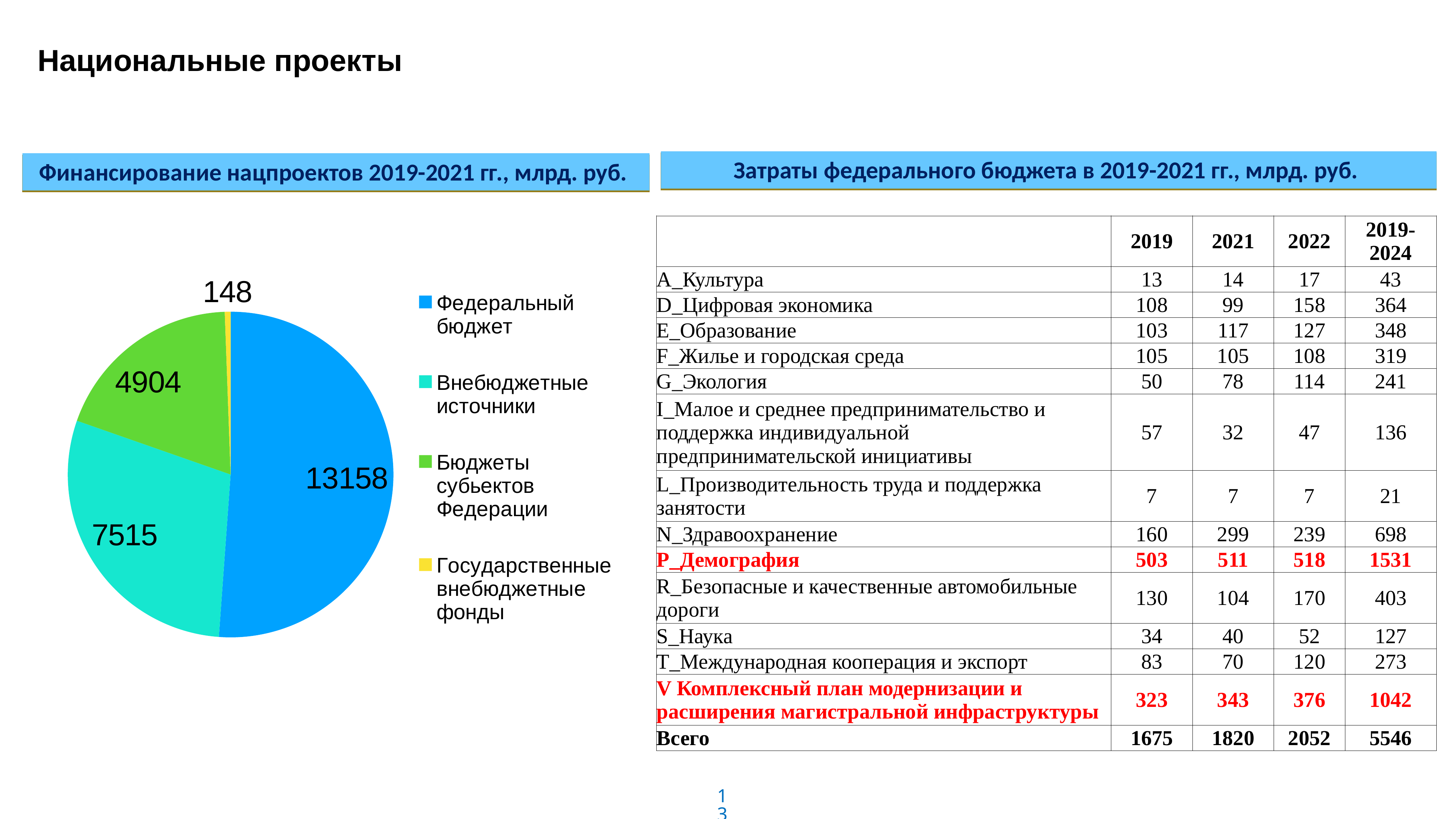
Which category has the largest slice in the pie chart? Федеральный бюджет In the pie chart, what is the value for Внебюджетные источники? 7515 How many slices does the pie chart have? 4 In the pie chart, what is the value for Федеральный бюджет? 13158 Which category has the smallest slice in the pie chart? Государственные внебюджетные фонды In the pie chart, which is larger: Внебюджетные источники or Бюджеты субъектов Федерации? Внебюджетные источники In the pie chart, what is the difference between Федеральный бюджет and Внебюджетные источники? 5643 What colour is the slice for Бюджеты субъектов Федерации in the pie chart? Green In the pie chart, what is the value for Государственные внебюджетные фонды? 148 In the pie chart, what is the value for Бюджеты субъектов Федерации? 4904 In the pie chart, what is the difference between Внебюджетные источники and Бюджеты субъектов Федерации? 2611 What kind of chart is shown under the heading "Финансирование нацпроектов 2019-2021 гг., млрд. руб."? Pie chart